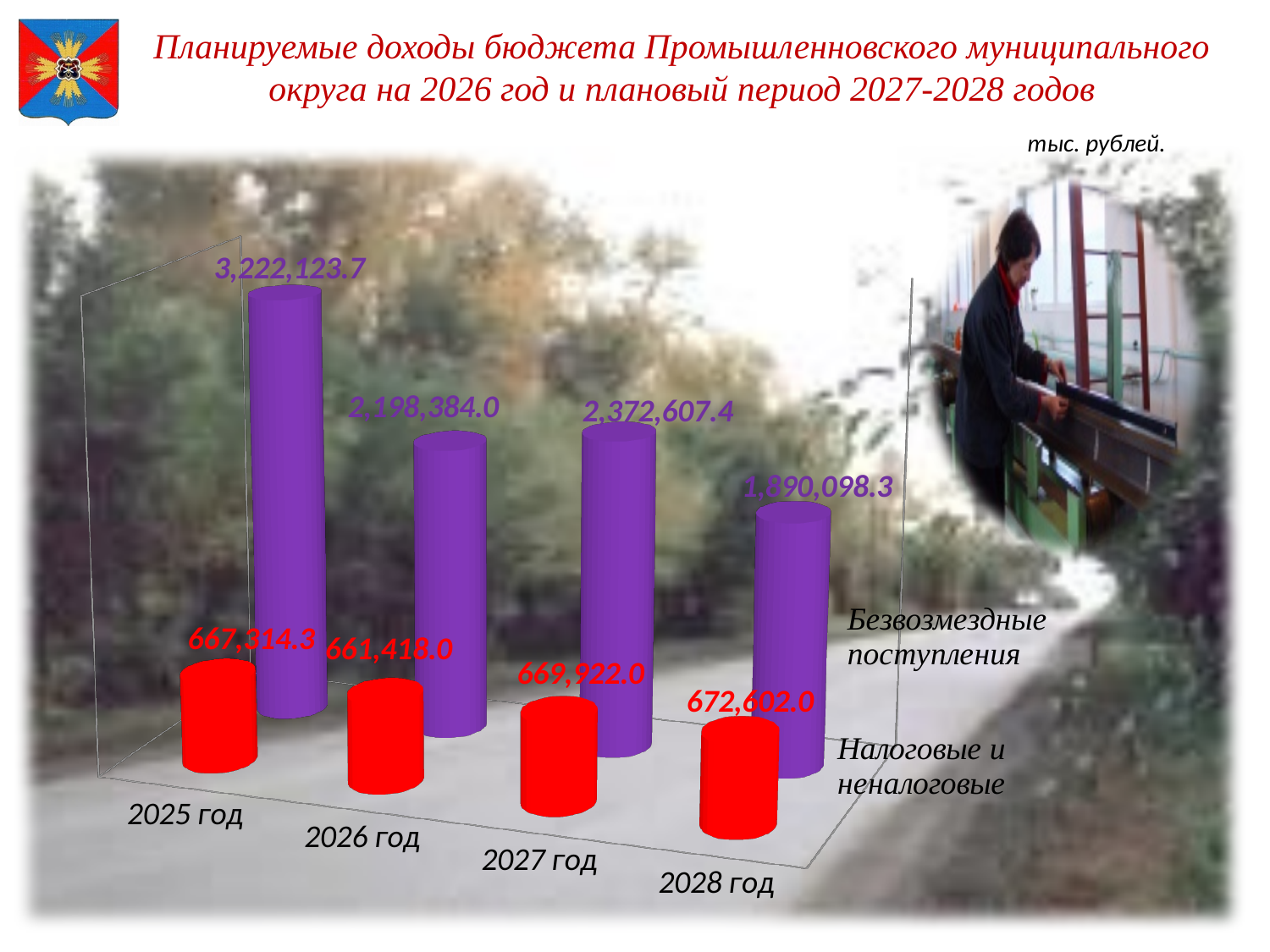
How many years are shown on the x axis? 4 How many series does the chart show? 2 In which year is Безвозмездные поступления the lowest? 2028 год What is the difference between Безвозмездные поступления in 2025 год and 2028 год? 1,332,025.4 Which is larger: Безвозмездные поступления in 2026 год or in 2027 год? 2027 год What kind of chart is shown on the slide? bar chart What is the value of Безвозмездные поступления for 2028 год? 1,890,098.3 In which year is Безвозмездные поступления the highest? 2025 год What is the value of Безвозмездные поступления for 2025 год? 3,222,123.7 What is the difference between Безвозмездные поступления in 2027 год and 2026 год? 174,223.4 What is the value of Налоговые и неналоговые for 2027 год? 669,922.0 In which year is Налоговые и неналоговые the lowest? 2026 год